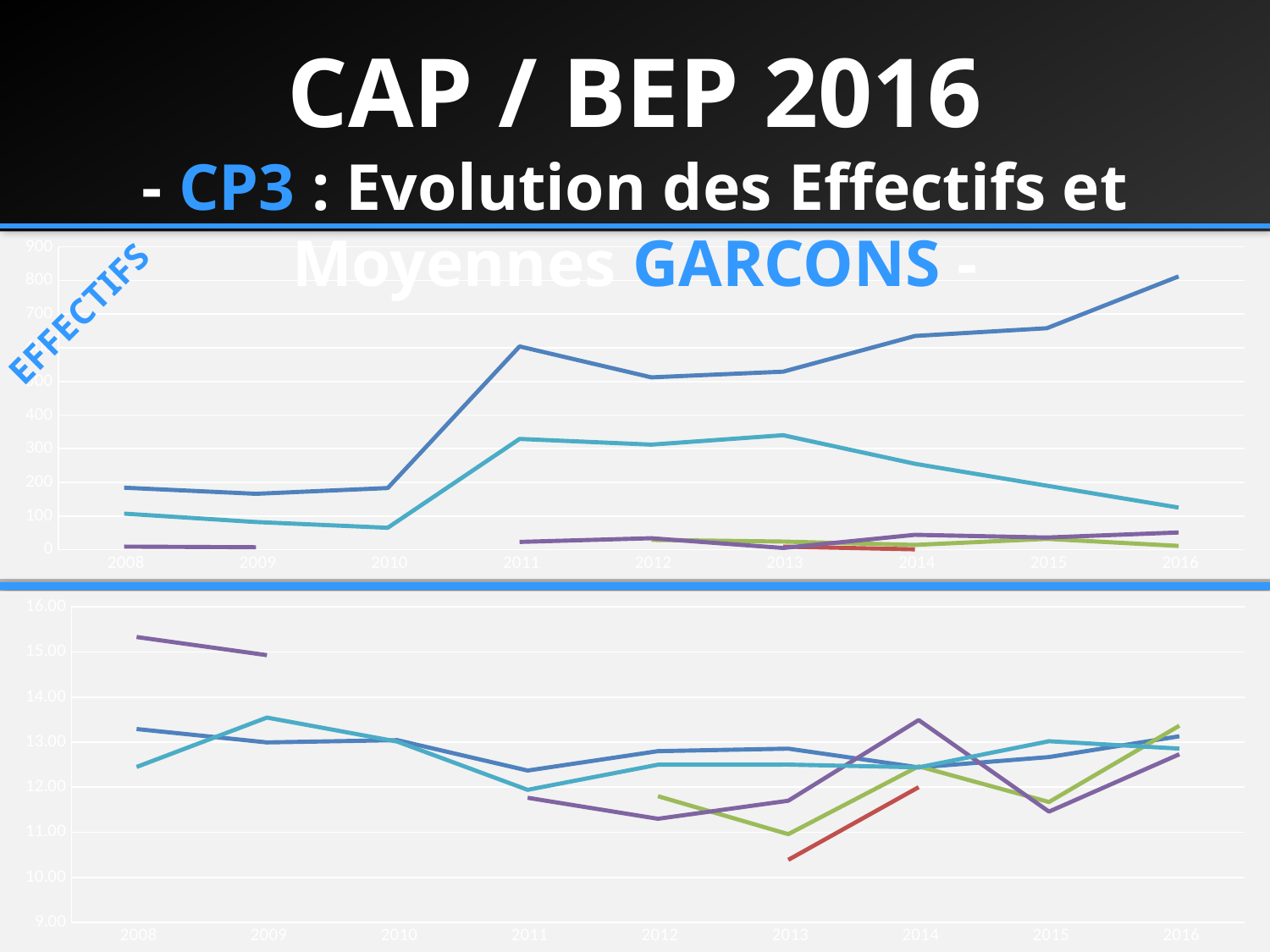
In the top chart (Effectifs), is the value of the teal line in 2010 greater or less than 100? less What kind of chart is the bottom chart? line chart In the top chart (Effectifs), is the value of the dark blue line in 2016 greater or less than 700? greater In the top chart (Effectifs), is the value of the dark blue line in 2011 greater or less than 500? greater In the bottom chart, what is the lowest value shown on the y axis? 9.00 In the top chart (Effectifs), how many years are shown on the x axis? 9 In the top chart (Effectifs), in which year does the dark blue line reach its highest value? 2016 In the top chart (Effectifs), does the teal line rise or fall from 2013 to 2016? falls In the top chart (Effectifs), does the dark blue line rise or fall from 2013 to 2016? rises What kind of chart is the top chart (Effectifs)? line chart